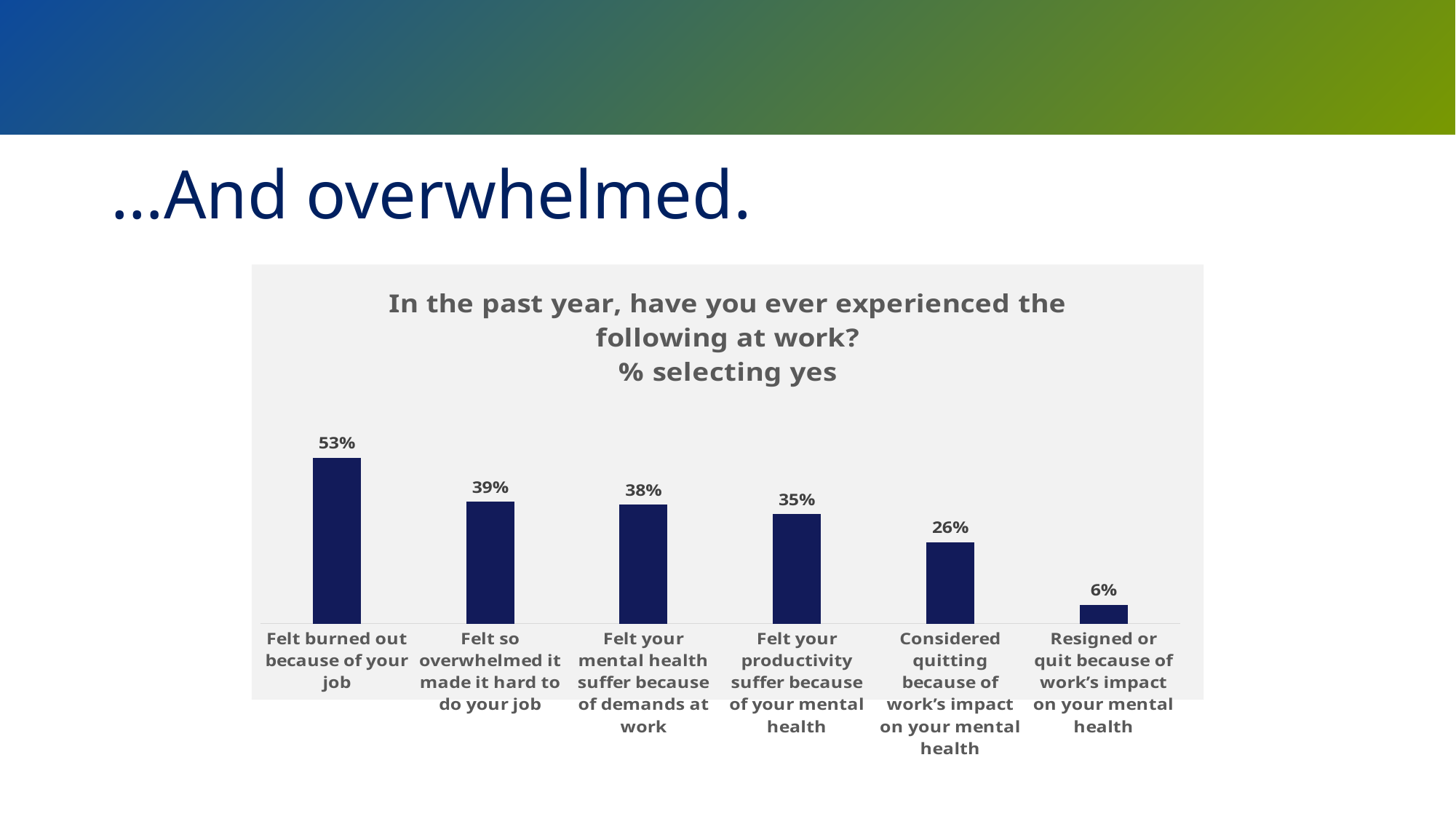
Which is larger: 'Felt your productivity suffer because of your mental health' or 'Considered quitting because of work's impact on your mental health'? Felt your productivity suffer because of your mental health What percentage selected yes for 'Felt burned out because of your job'? 53% What percentage selected yes for 'Felt so overwhelmed it made it hard to do your job'? 39% Which category has the lowest percentage selecting yes? Resigned or quit because of work's impact on your mental health What is the difference between 'Felt burned out because of your job' and 'Felt so overwhelmed it made it hard to do your job'? 14% Do the values rise or fall from left to right across the categories? Fall What percentage selected yes for 'Resigned or quit because of work's impact on your mental health'? 6% What kind of chart is shown on the slide? Bar chart Which category has the highest percentage selecting yes? Felt burned out because of your job What is the difference between 'Considered quitting because of work's impact on your mental health' and 'Resigned or quit because of work's impact on your mental health'? 20% What percentage selected yes for 'Considered quitting because of work's impact on your mental health'? 26% How many categories are shown in the chart? 6